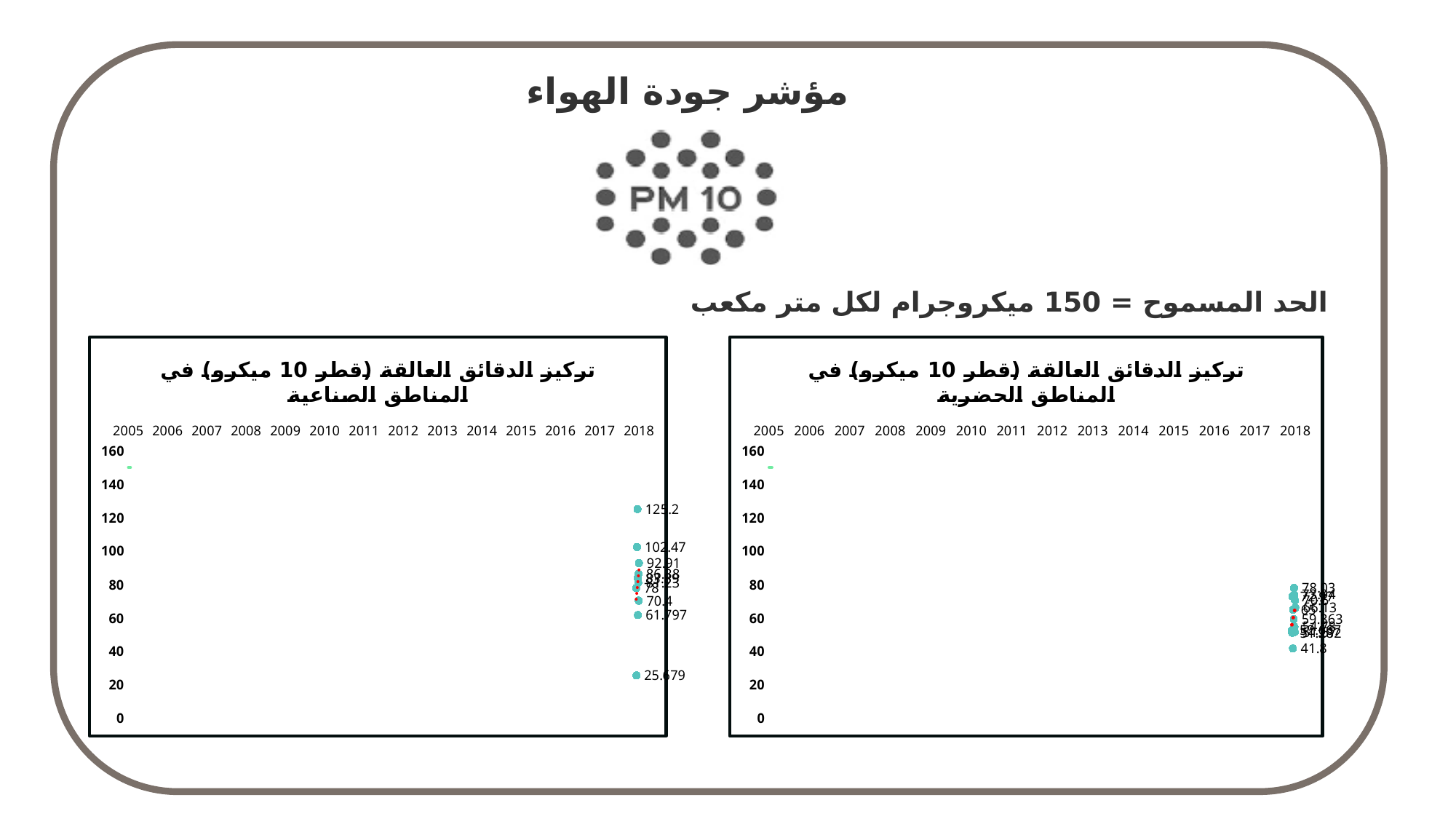
What kind of chart is the right chart (urban areas)? scatter (dot) chart On the right chart (urban areas), what is the lowest labelled value? 41.8 On the left chart (industrial areas), what is the highest labelled value? 125.2 On the left chart (industrial areas), what is the difference between the highest labelled value (125.2) and the lowest labelled value (25.679)? 99.521 Which chart has the larger maximum labelled value, the left chart (industrial areas) or the right chart (urban areas)? the left chart (industrial areas) What is the maximum value shown on the y axis of the left chart (industrial areas)? 160 On the right chart (urban areas), what is the difference between the highest labelled value (78.03) and the lowest labelled value (41.3)? 36.23 How many years are listed along the x axis of the left chart (industrial areas)? 14 On the left chart (industrial areas), what is the lowest labelled value? 25.679 On the right chart (urban areas), what is the highest labelled value? 78.03